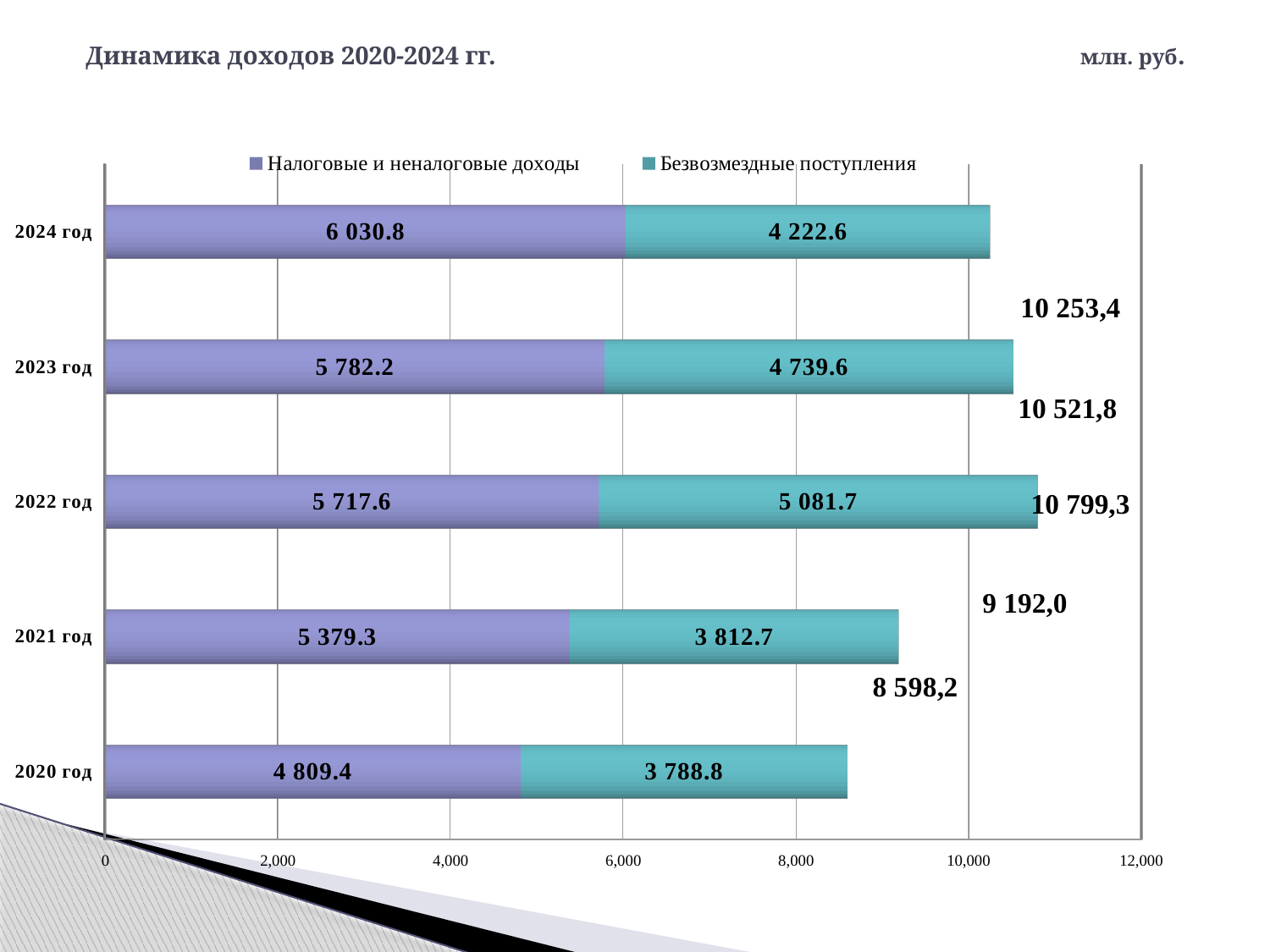
Which year has the lowest value for Безвозмездные поступления? 2020 год How many years are shown on the chart? 5 What is the title of the chart? Динамика доходов 2020-2024 гг. Which year has the highest value for Налоговые и неналоговые доходы? 2024 год What is the value of Безвозмездные поступления for 2021 год? 3 812.7 What is the difference between Налоговые и неналоговые доходы in 2024 год and 2023 год? 248.6 Which is larger: Безвозмездные поступления in 2023 год or in 2024 год? 2023 год How many series does the legend list? 2 What is the value of Налоговые и неналоговые доходы for 2024 год? 6 030.8 What kind of chart is shown on the slide? Stacked bar chart What is the total of the stacked bar for 2020 год? 8 598,2 Which year has the highest value for Безвозмездные поступления? 2022 год